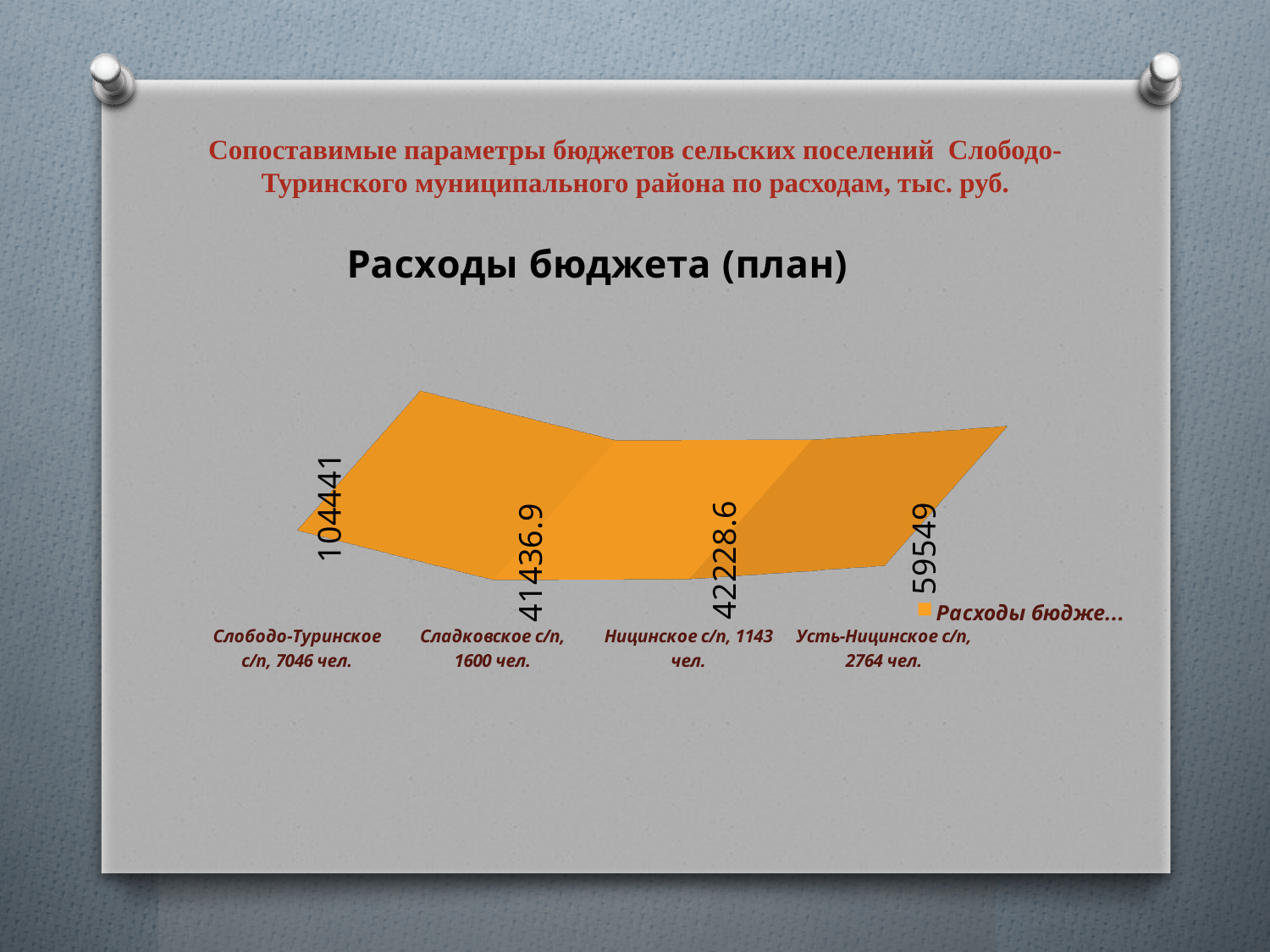
What is the planned budget expenditure for Усть-Ницинское с/п? 59549 What is the difference between the planned expenditures of Ницинское с/п and Сладковское с/п? 791.7 Which settlement has the highest planned budget expenditure? Слободо-Туринское с/п What is the planned budget expenditure for Ницинское с/п? 42228.6 What is the planned budget expenditure for Слободо-Туринское с/п? 104441 How many settlements are shown in the chart? 4 What is the planned budget expenditure for Сладковское с/п? 41436.9 Which settlement has the lowest planned budget expenditure? Сладковское с/п What kind of chart is used to show the planned budget expenditures? 3D line chart What is the difference between the planned expenditures of Слободо-Туринское с/п and Усть-Ницинское с/п? 44892 Which has the larger planned expenditure, Усть-Ницинское с/п or Ницинское с/п? Усть-Ницинское с/п What is the title of the chart? Расходы бюджета (план)